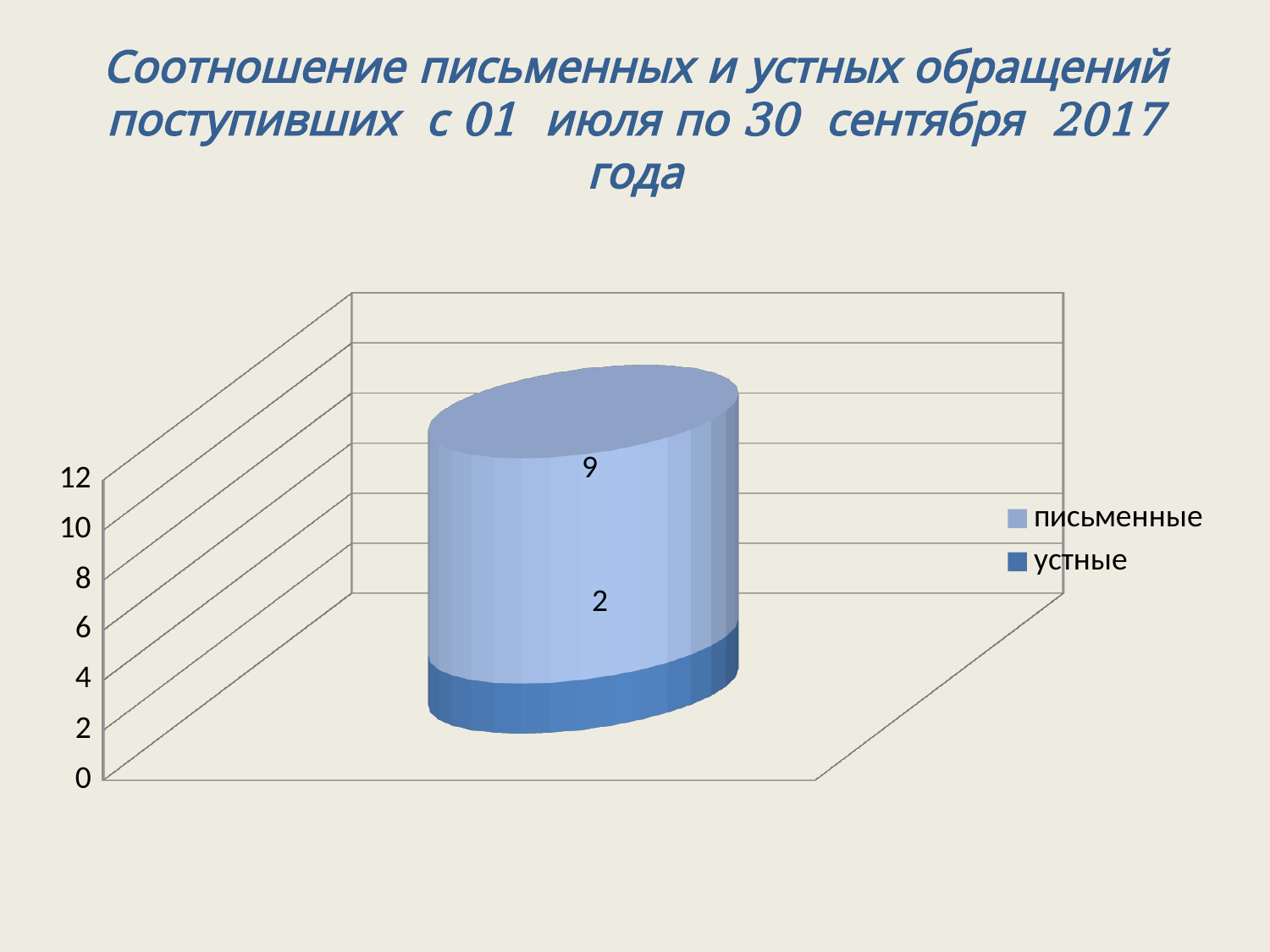
Which series has the larger value, письменные or устные? письменные What is the highest value shown on the vertical axis? 12 What is the value for the устные series? 2 What is the total of the stacked bar (письменные plus устные)? 11 What is the value for the письменные series? 9 What kind of chart is shown on the slide? stacked bar chart Which series has the largest value? письменные What is the difference between the письменные value and the устные value? 7 Which series has the smallest value? устные Is the value for письменные greater or less than 6? greater Which legend entry is shown in the darker blue colour? устные How many series does the legend list? 2